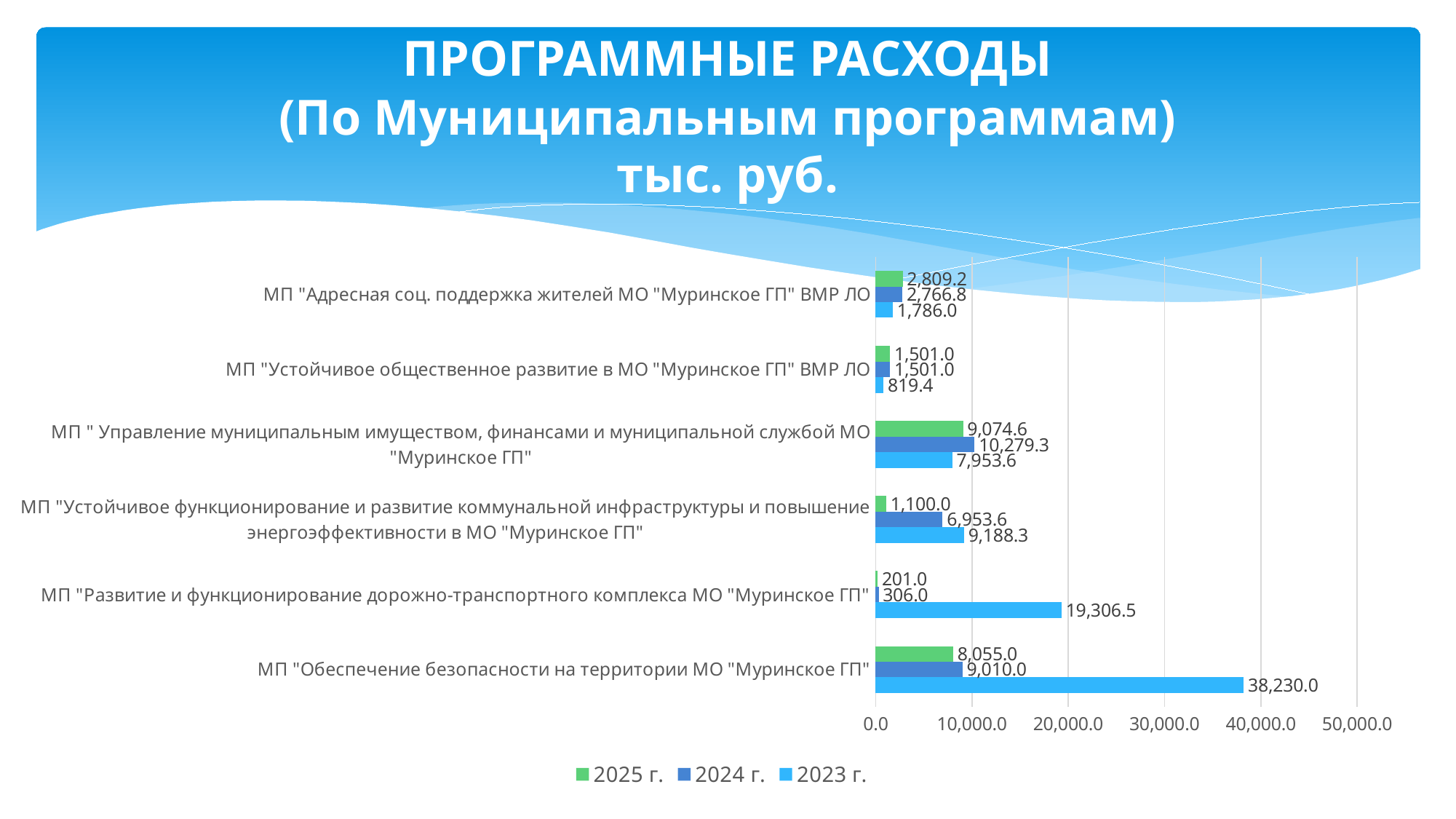
For МП "Устойчивое функционирование и развитие коммунальной инфраструктуры и повышение энергоэффективности в МО "Муринское ГП"", which is larger: the 2024 г. value or the 2025 г. value? 2024 г. Which programme has the lowest 2025 г. value? МП "Развитие и функционирование дорожно-транспортного комплекса МО "Муринское ГП"" How many municipal programmes (categories) are shown on the chart? 6 Is the 2023 г. value for МП "Обеспечение безопасности на территории МО "Муринское ГП"" greater or less than 30,000.0? greater How many series does the legend list? 3 What unit of measurement is stated in the chart title? тыс. руб. What is the 2024 г. value for МП "Управление муниципальным имуществом, финансами и муниципальной службой МО "Муринское ГП""? 10,279.3 What is the 2025 г. value for МП "Развитие и функционирование дорожно-транспортного комплекса МО "Муринское ГП""? 201.0 Which programme has the highest 2023 г. value? МП "Обеспечение безопасности на территории МО "Муринское ГП"" What is the difference between the 2023 г. and 2024 г. values for МП "Развитие и функционирование дорожно-транспортного комплекса МО "Муринское ГП""? 19,000.5 What is the 2023 г. value for МП "Обеспечение безопасности на территории МО "Муринское ГП""? 38,230.0 What type of chart is shown on the slide? Bar chart